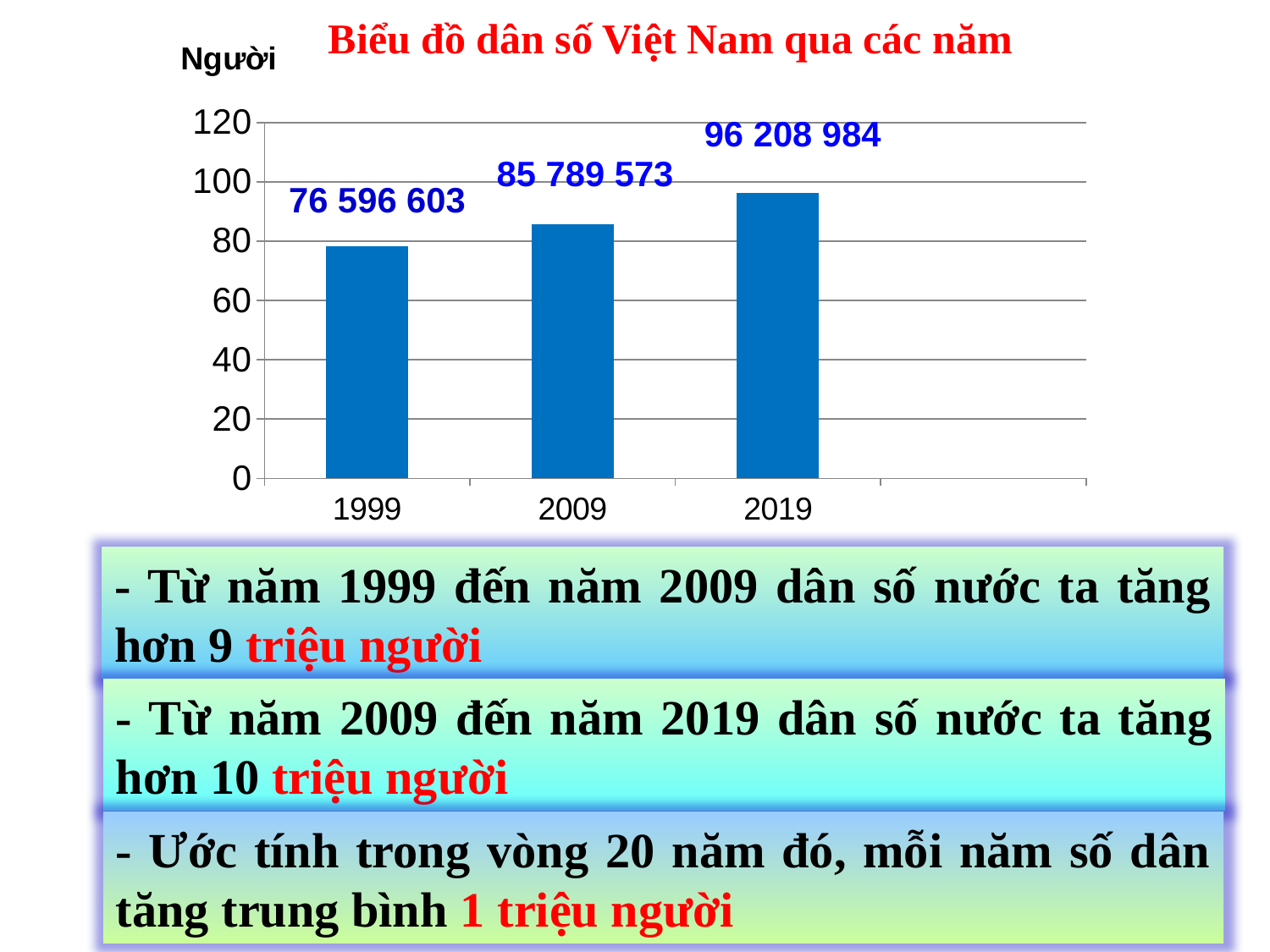
What is the title of the chart? Biểu đồ dân số Việt Nam qua các năm Do the population values rise or fall from 1999 to 2019? rise What is the population value shown for 2009? 85 789 573 Which year has the lowest population in the chart? 1999 What is the difference between the population values for 2009 and 1999? 9 192 970 How many years (bars) are shown in the chart? 3 What is the difference between the population values for 2019 and 2009? 10 419 411 What is the population value shown for 1999? 76 596 603 What type of chart is shown on the slide? bar chart What is the population value shown for 2019? 96 208 984 Which year has the highest population in the chart? 2019 Is the bar for 2019 greater or less than 100 on the axis? less